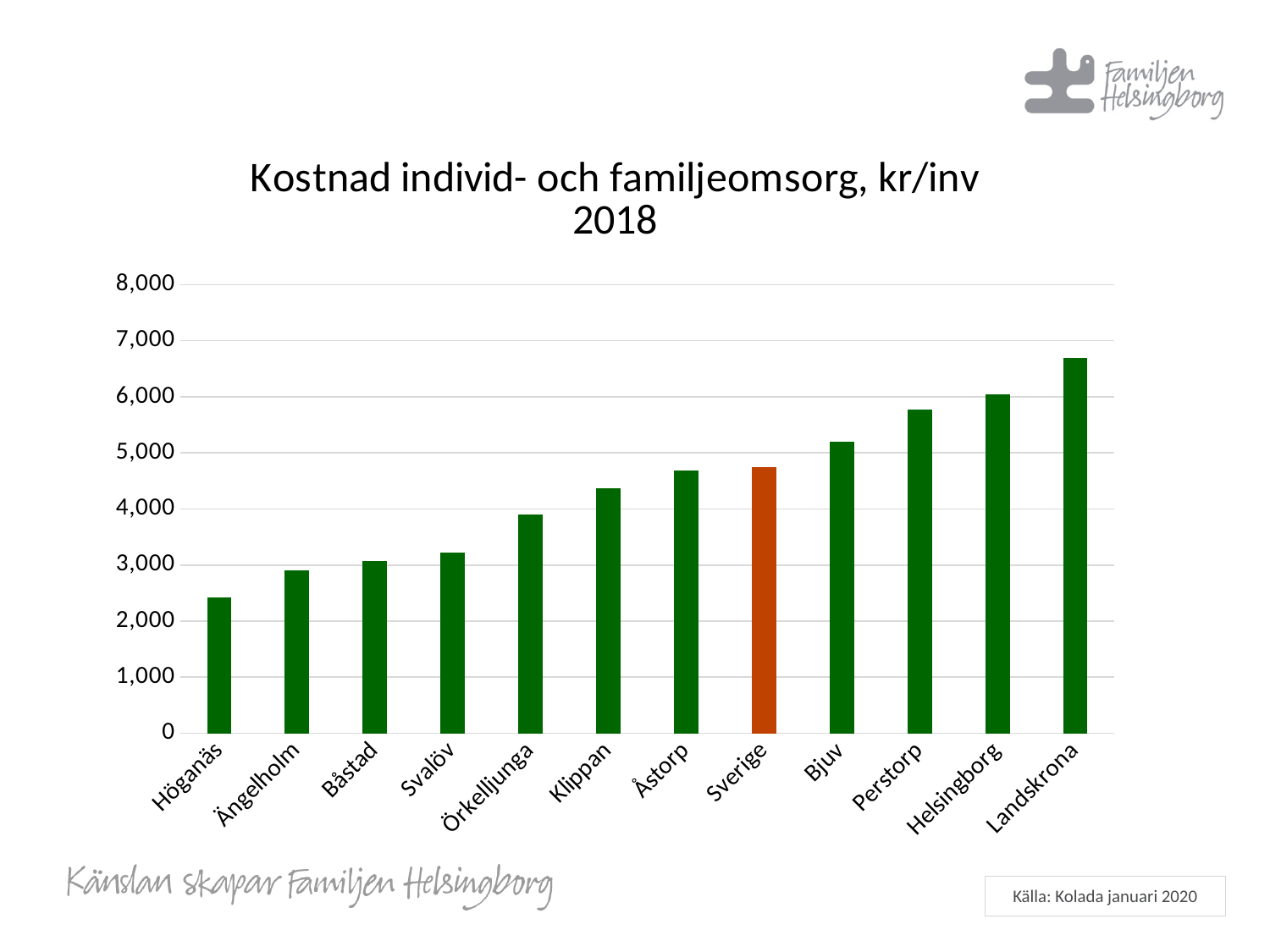
Do the values rise or fall from left to right along the x axis? rise Is the value for Landskrona greater or less than 6,000? greater How many categories are shown on the x axis of the chart? 12 Is the value for Perstorp greater or less than 6,000? less Which category has the highest value in the chart? Landskrona Is the value for Bjuv greater or less than 5,000? greater Which category's bar is shown in a different colour (orange) from the others? Sverige Which category has the lowest value in the chart? Höganäs What kind of chart is shown on the slide? Bar chart Which is larger, the value for Bjuv or the value for Klippan? Bjuv